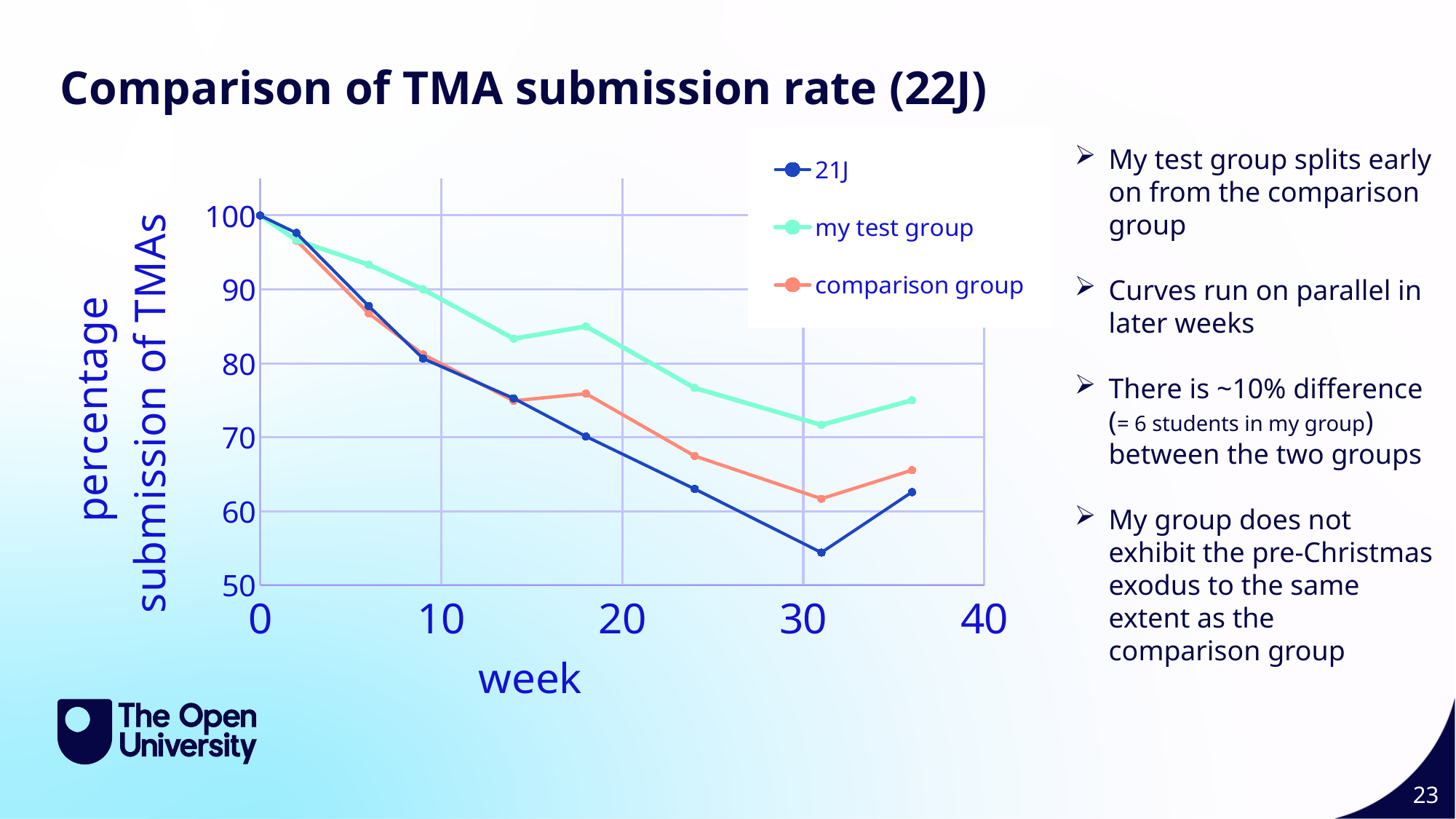
Is the value for my test group at around week 31 greater or less than 70? greater What kind of chart is shown on the slide? line chart Is the value for the comparison group at around week 24 greater or less than 70? less Do the values for the 21J series rise or fall from week 0 to week 31? fall How many series does the chart legend list? 3 Is the value for the 21J series at its lowest point (around week 31) greater or less than 60? less What is the title of the chart on the slide? Comparison of TMA submission rate (22J) What is the percentage submission of TMAs for the 21J series at week 0? 100 Which series has the highest value at around week 31? my test group What is the label of the x axis of the chart? week Which series has the lowest value at around week 31? 21J